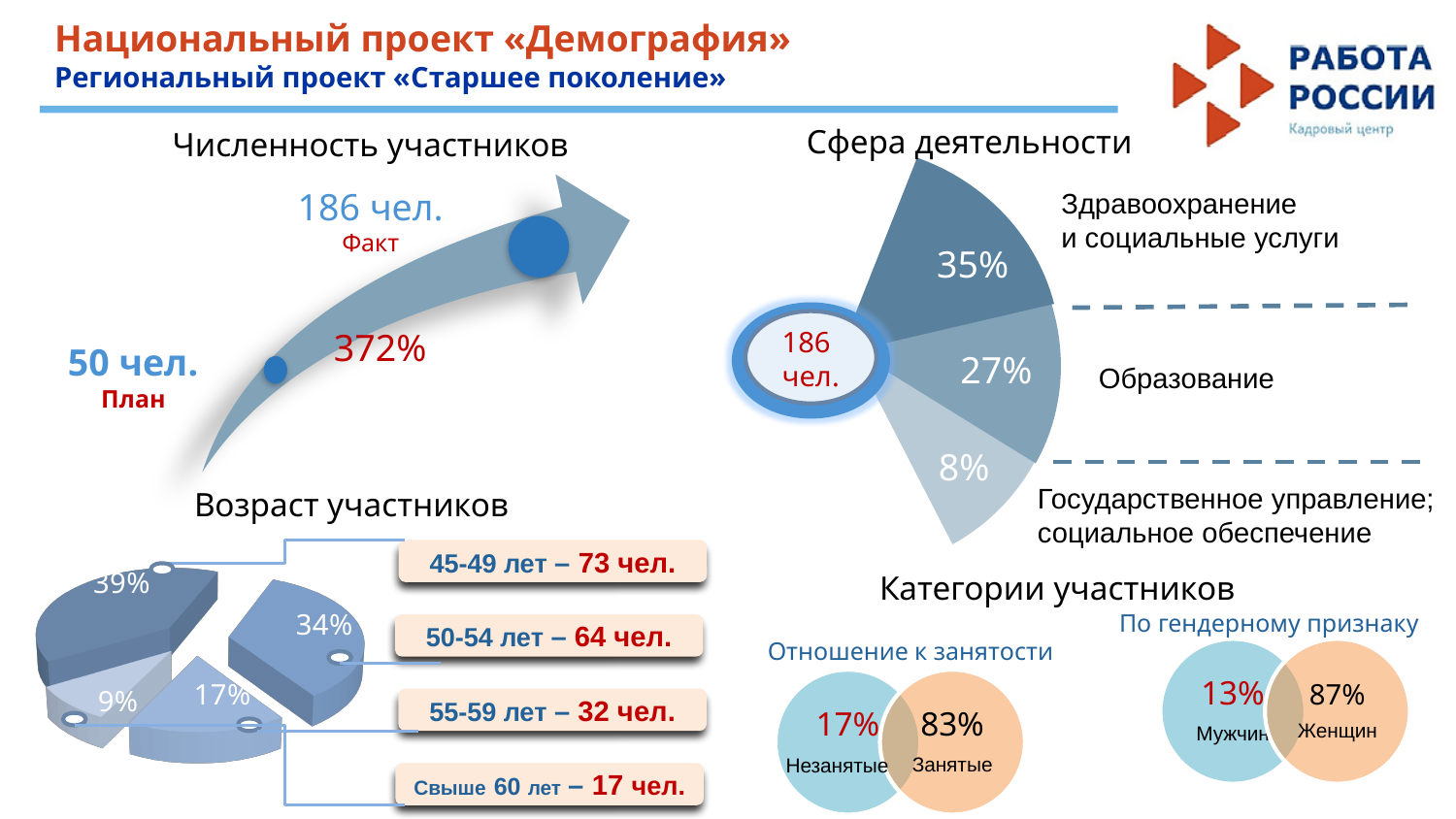
На диаграмме «Численность участников» какой процент выполнения плана указан? 372% На диаграмме «Возраст участников» на сколько человек группа 50-54 лет больше группы 55-59 лет? 32 чел. На диаграмме «Численность участников» какое плановое значение указано? 50 чел. Сколько сфер деятельности показано на диаграмме «Сфера деятельности»? 3 На диаграмме «Сфера деятельности» какая доля приходится на «Образование»? 27% На диаграмме «Сфера деятельности» какая сфера имеет наименьшую долю? Государственное управление; социальное обеспечение Какого типа диаграмма «Возраст участников»? Круговая диаграмма На диаграмме «Категории участников» какая доля женщин по гендерному признаку? 87% На диаграмме «Сфера деятельности» какая доля приходится на «Здравоохранение и социальные услуги»? 35% На диаграмме «Возраст участников» сколько человек в группе свыше 60 лет? 17 чел. На диаграмме «Возраст участников» какая возрастная группа самая многочисленная? 45-49 лет На диаграмме «Возраст участников» сколько человек в группе 45-49 лет? 73 чел.